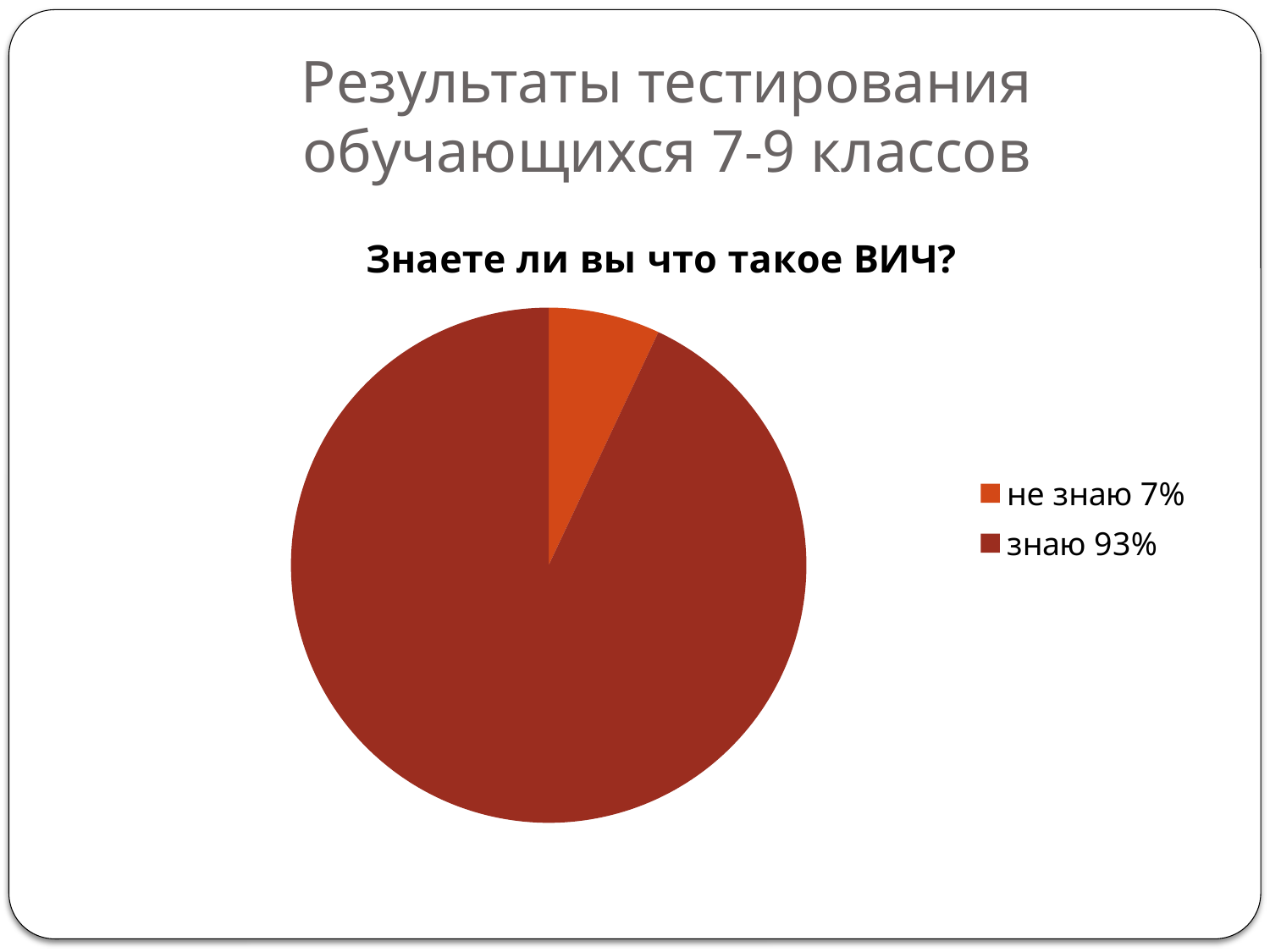
What is the total of the two slices' percentages? 100% Which is larger, the "знаю" slice or the "не знаю" slice? знаю What kind of chart is shown on the slide? pie chart What share of the pie is labelled "знаю"? 93% What colour is the "не знаю" slice? orange Which slice is the smallest? не знаю 7% Which slice is the largest? знаю 93% How many slices does the pie chart have? 2 What share of the pie is labelled "не знаю"? 7% What is the difference in percentage points between the "знаю" and "не знаю" slices? 86 What is the title of the chart? Знаете ли вы что такое ВИЧ?